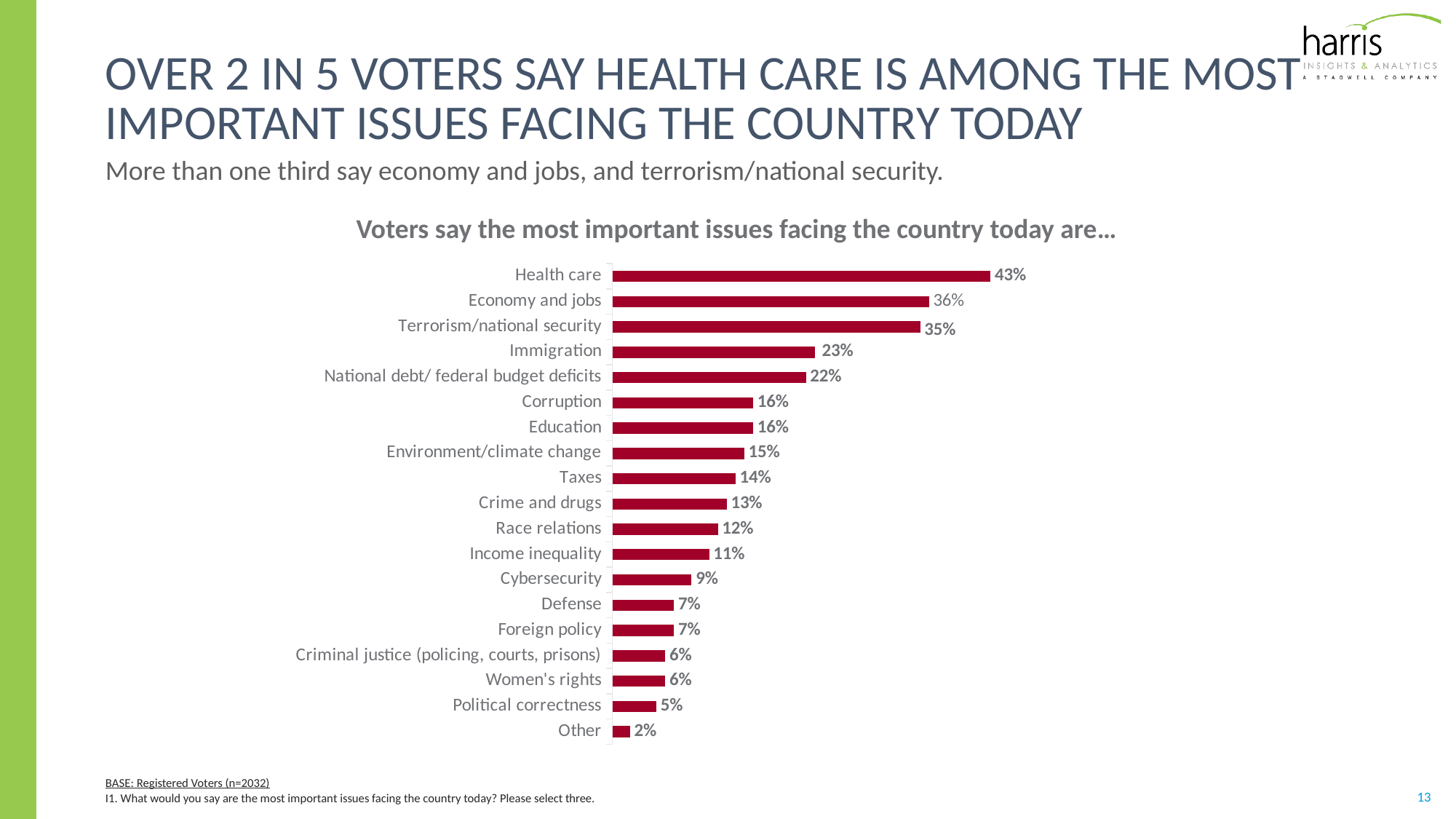
Which issue has the highest percentage in the chart? Health care What is the difference in percentage points between Health care and Economy and jobs? 7 What type of chart is shown on the slide? Bar chart What is the difference in percentage points between Immigration and Taxes? 9 What is the value shown for Immigration? 23% What percentage is shown for Cybersecurity? 9% How many issue categories are shown in the chart? 19 Which has a higher value, Terrorism/national security or National debt/ federal budget deficits? Terrorism/national security Which has a higher value, Race relations or Political correctness? Race relations What is the title of the chart? Voters say the most important issues facing the country today are… What percentage of voters say health care is among the most important issues facing the country today? 43% Which category has the lowest percentage in the chart? Other